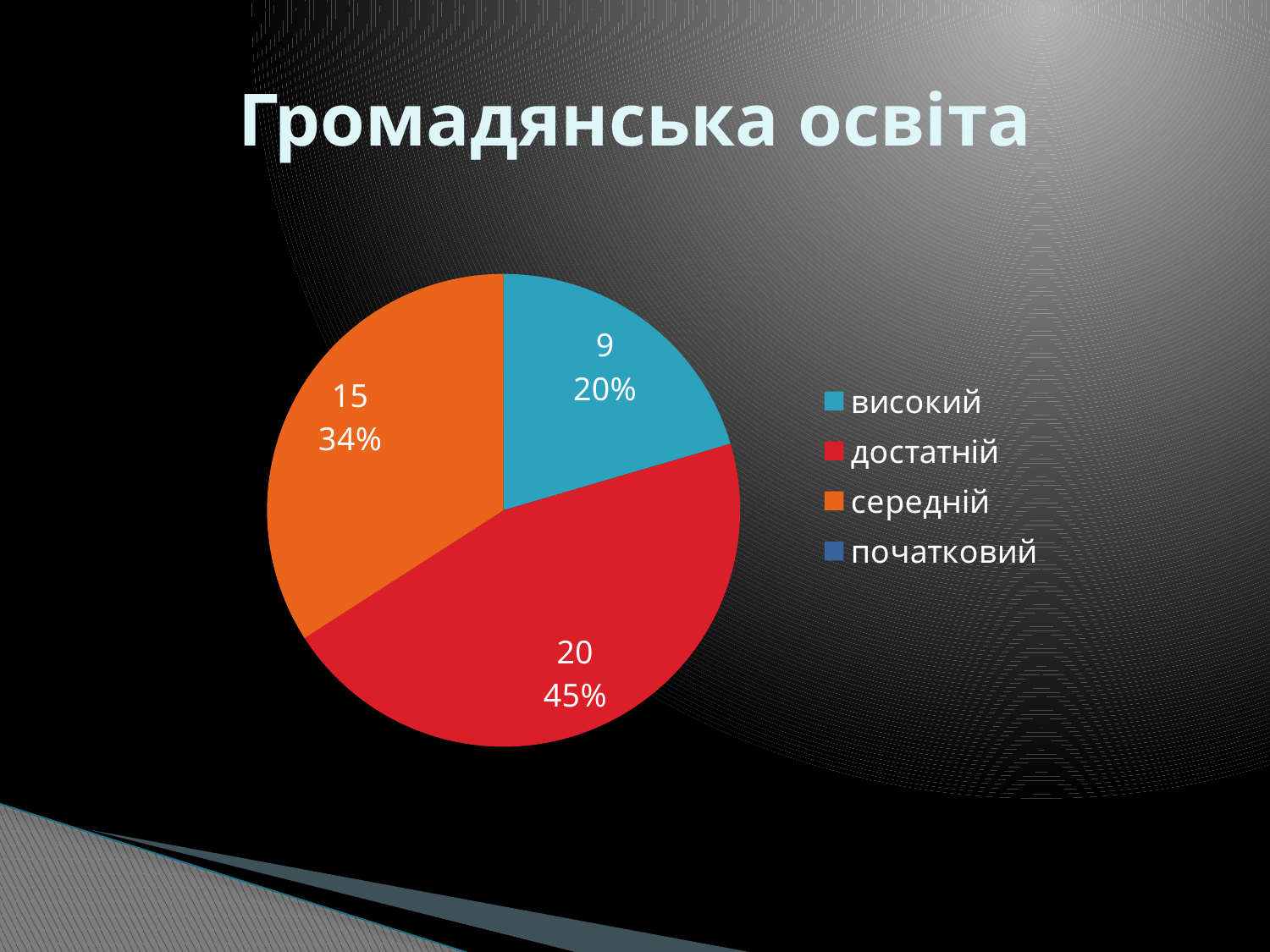
What kind of chart is shown on the slide? pie chart What is the value for середній? 15 What is the title of the chart? Громадянська освіта What is the value for достатній? 20 Which is larger, the value for середній or the value for високий? середній Which category has the largest slice? достатній What is the difference between the values for достатній and високий? 11 What share of the pie does достатній take? 45% What share of the pie does середній take? 34% Which of the labelled slices is the smallest? високий How many entries does the legend list? 4 What is the value for високий? 9